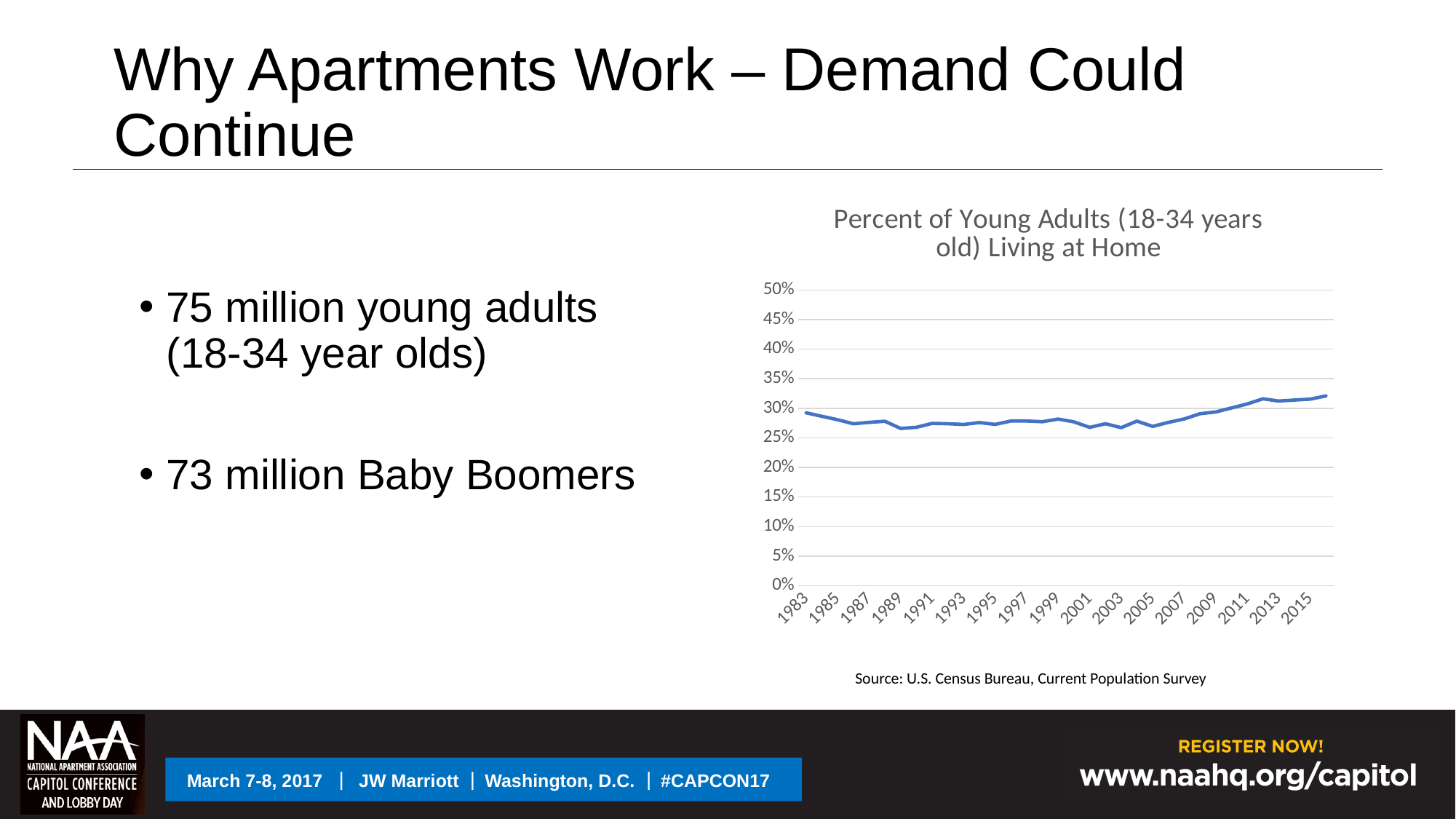
Which year has the larger value, 1983 or 2005? 1983 What is the source cited below the chart? U.S. Census Bureau, Current Population Survey Does the percentage of young adults living at home rise or fall between 2005 and 2015? rise Which year has the larger value, 2015 or 1989? 2015 Is the value for 1989 greater or less than 30%? less What kind of chart is shown on the slide? line chart Is the value for 1989 greater or less than 25%? greater Is the value for 2013 greater or less than 30%? greater How many year labels are shown on the x axis? 17 What is the title of the chart? Percent of Young Adults (18-34 years old) Living at Home